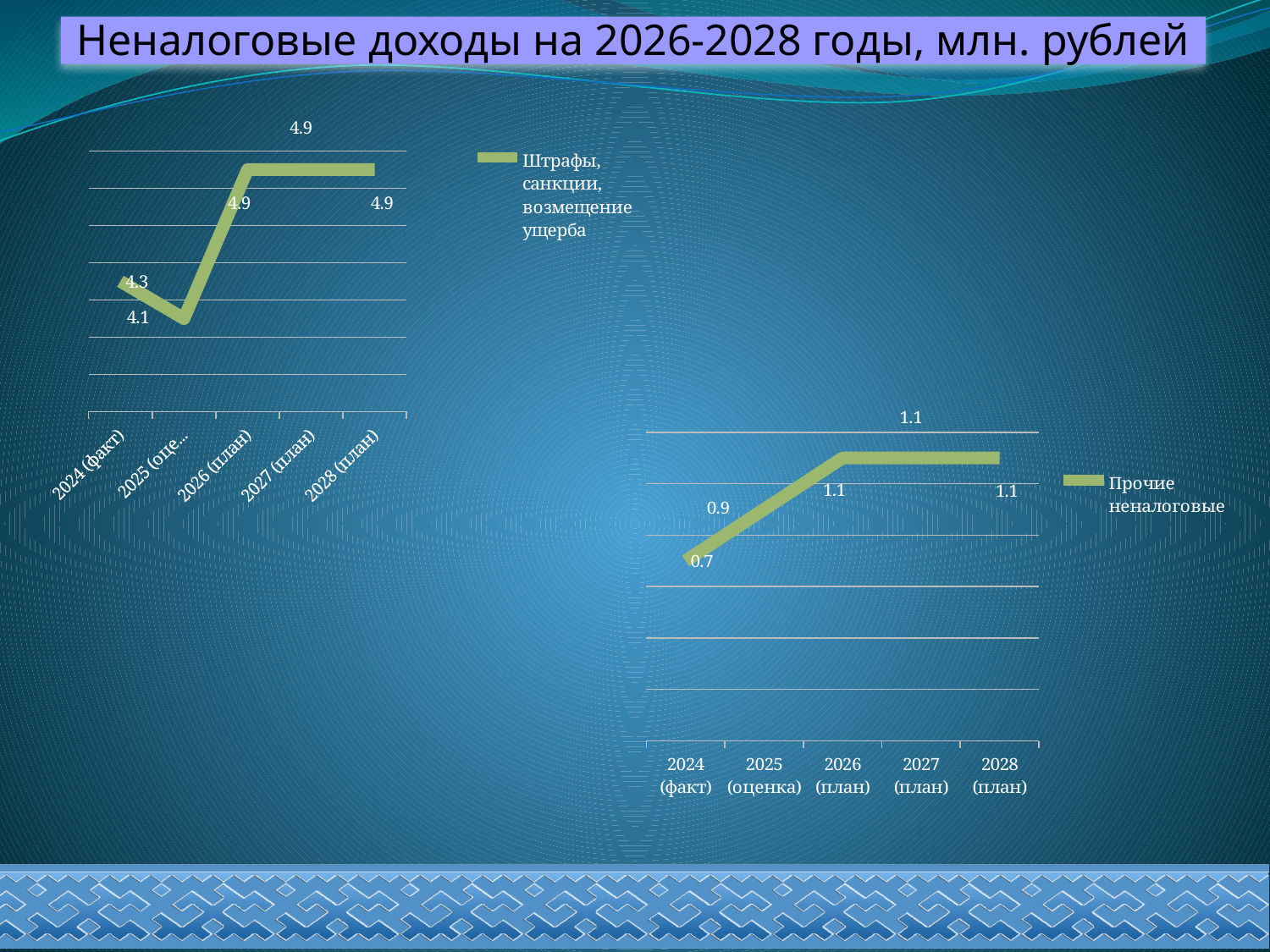
On the right chart (Прочие неналоговые), what is the value for 2025 (оценка)? 0.9 On the right chart (Прочие неналоговые), what is the value for 2028 (план)? 1.1 On the left chart (Штрафы, санкции, возмещение ущерба), which is larger: the value for 2024 (факт) or the value for 2025? 2024 (факт) On the right chart (Прочие неналоговые), how many data points are plotted? 5 What type of chart is the right chart (Прочие неналоговые)? Line chart On the left chart (Штрафы, санкции, возмещение ущерба), what is the value for 2024 (факт)? 4.3 On the left chart (Штрафы, санкции, возмещение ущерба), what is the value for 2025? 4.1 On the left chart (Штрафы, санкции, возмещение ущерба), which year has the lowest value? 2025 On the right chart (Прочие неналоговые), what is the difference between the 2026 (план) value and the 2024 (факт) value? 0.4 On the left chart (Штрафы, санкции, возмещение ущерба), what is the value for 2026 (план)? 4.9 On the right chart (Прочие неналоговые), what is the value for 2024 (факт)? 0.7 On the left chart (Штрафы, санкции, возмещение ущерба), what is the difference between the 2026 (план) value and the 2025 value? 0.8